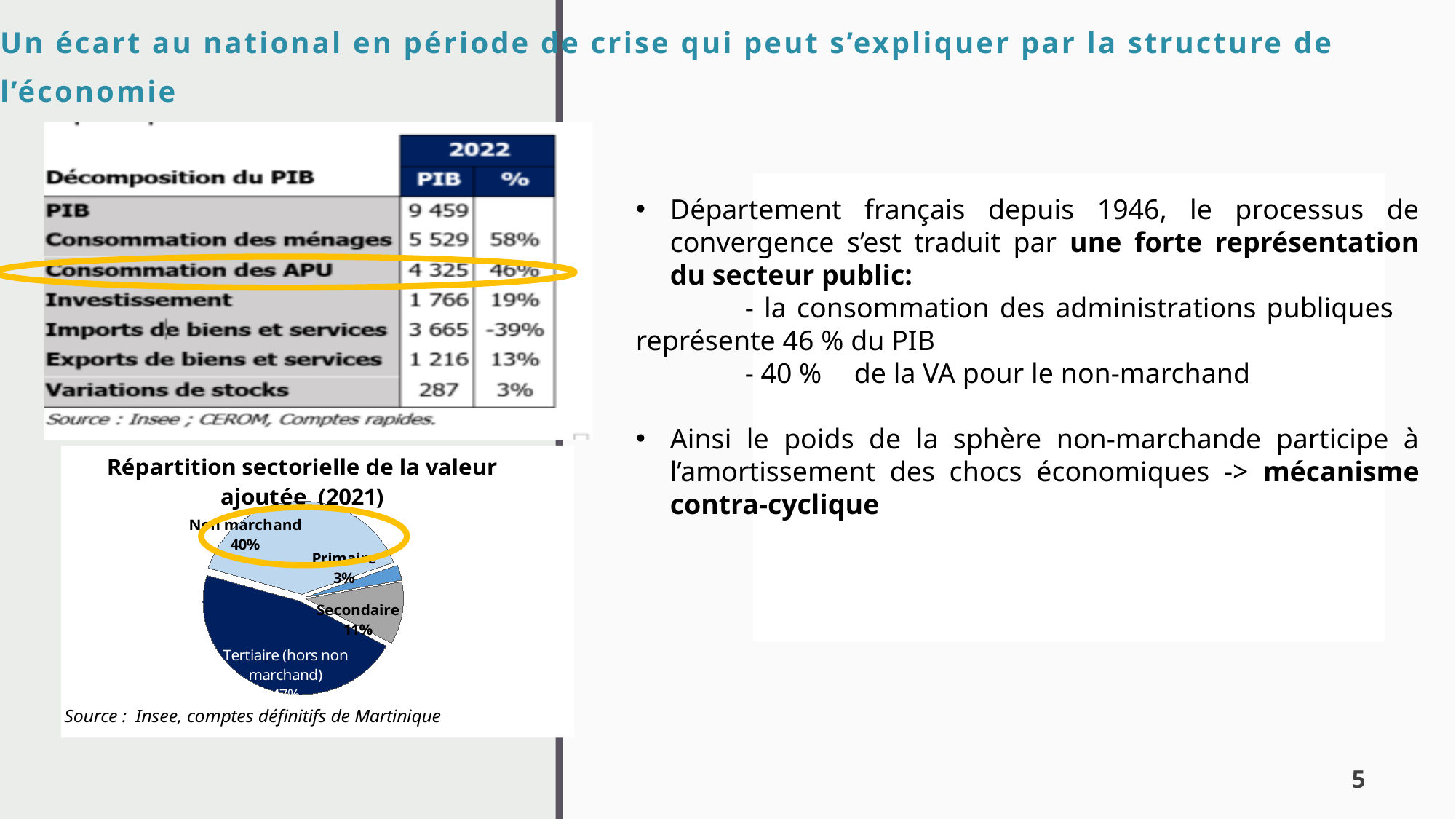
In the pie chart 'Répartition sectorielle de la valeur ajoutée (2021)', which sector has the largest slice? Tertiaire (hors non marchand) In the pie chart 'Répartition sectorielle de la valeur ajoutée (2021)', what is the difference between the 'Non marchand' share and the 'Secondaire' share? 29% What source is cited below the pie chart 'Répartition sectorielle de la valeur ajoutée (2021)'? Insee, comptes définitifs de Martinique What kind of chart is shown under the title 'Répartition sectorielle de la valeur ajoutée (2021)'? pie chart In the pie chart 'Répartition sectorielle de la valeur ajoutée (2021)', what share does 'Non marchand' have? 40% How many slices does the pie chart 'Répartition sectorielle de la valeur ajoutée (2021)' have? 4 In the pie chart 'Répartition sectorielle de la valeur ajoutée (2021)', which sector has the smallest slice? Primaire In the pie chart 'Répartition sectorielle de la valeur ajoutée (2021)', what is the difference between the 'Secondaire' share and the 'Primaire' share? 8% What is the title of the pie chart on the slide? Répartition sectorielle de la valeur ajoutée (2021) In the pie chart 'Répartition sectorielle de la valeur ajoutée (2021)', what share does 'Primaire' have? 3% In the pie chart 'Répartition sectorielle de la valeur ajoutée (2021)', which is larger: 'Non marchand' or 'Secondaire'? Non marchand In the pie chart 'Répartition sectorielle de la valeur ajoutée (2021)', what share does 'Secondaire' have? 11%